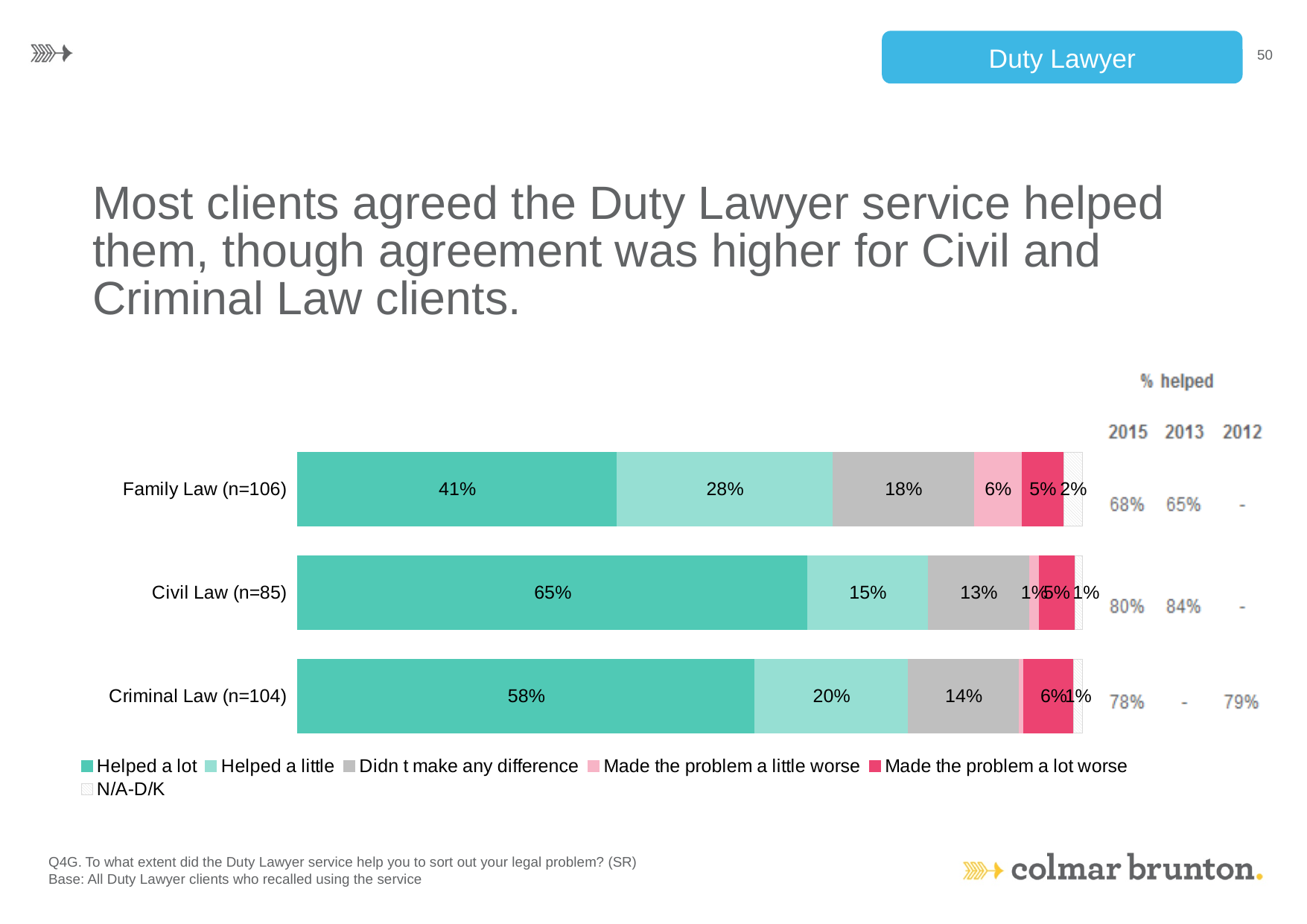
How many response categories does the legend list? 6 What percentage of Family Law clients said the Duty Lawyer service "Helped a lot"? 41% What type of chart is used on this slide? Stacked bar chart What percentage of Civil Law clients said the service "Helped a little"? 15% Which group has a larger "Helped a little" share, Family Law or Criminal Law? Family Law What colour represents "Made the problem a lot worse" in the legend? Red/pink (dark pink) Which client group has the lowest "Helped a lot" percentage? Family Law (n=106) According to the "% helped" table, what was the 2015 figure for Civil Law clients? 80% What percentage of Criminal Law clients said the service "Didn't make any difference"? 14% How many client groups (bars) are shown in the chart? 3 How many percentage points higher is the "Helped a lot" share for Civil Law than for Family Law? 24 percentage points Which client group has the highest "Helped a lot" percentage? Civil Law (n=85)